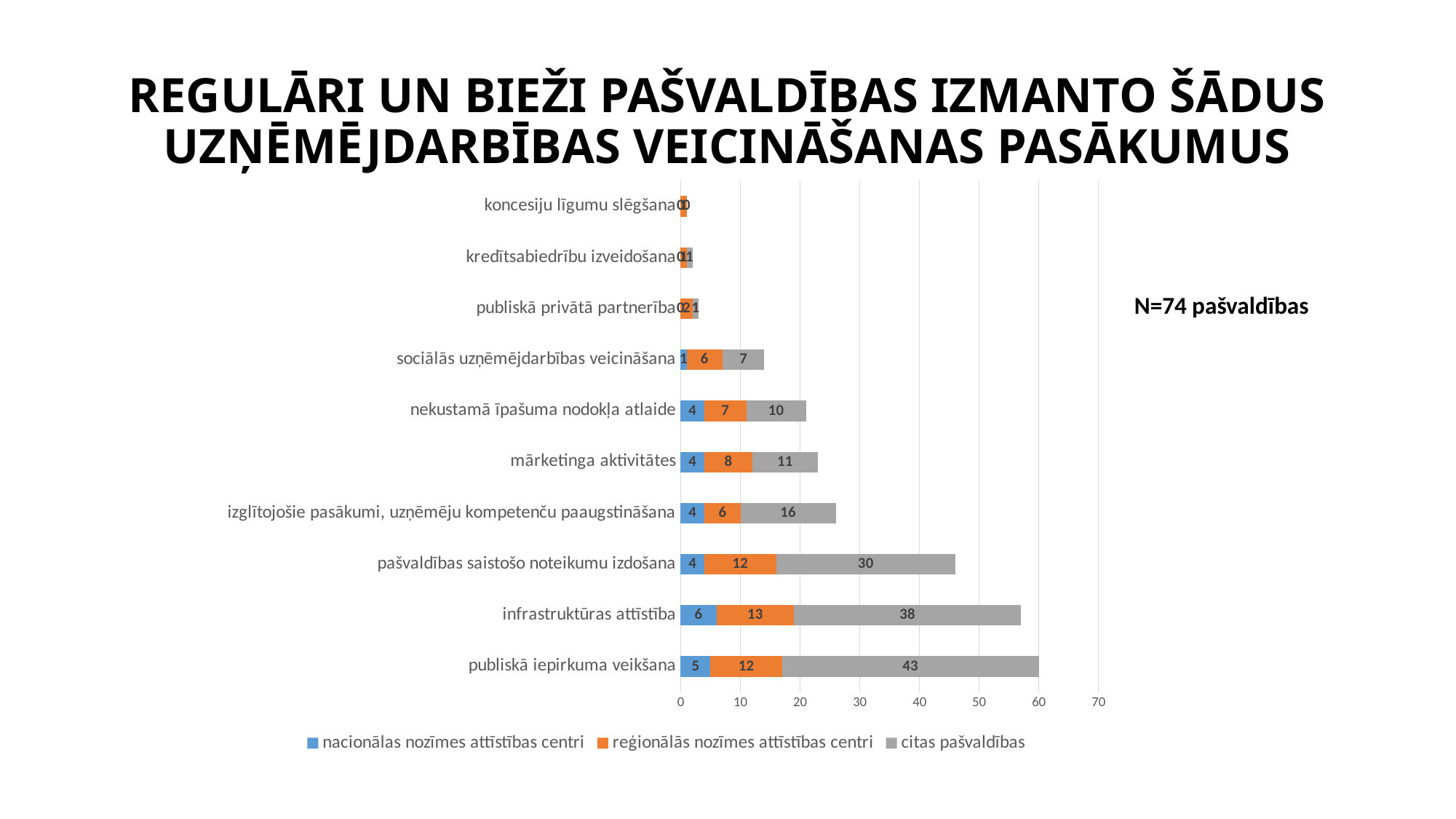
What is the difference between the 'citas pašvaldības' values for 'publiskā iepirkuma veikšana' and 'infrastruktūras attīstība'? 5 What type of chart is shown on the slide? stacked bar chart How many series does the legend list? 3 What sample size is stated next to the chart? N=74 pašvaldības What is the total of the stacked bar for 'infrastruktūras attīstība'? 57 What is the value for 'citas pašvaldības' in the 'publiskā iepirkuma veikšana' category? 43 How many categories are plotted on the chart? 10 Which is larger: the 'citas pašvaldības' value for 'mārketinga aktivitātes' or for 'izglītojošie pasākumi, uzņēmēju kompetenču paaugstināšana'? izglītojošie pasākumi, uzņēmēju kompetenču paaugstināšana What is the total of the stacked bar for 'pašvaldības saistošo noteikumu izdošana'? 46 Which category has the highest value for 'citas pašvaldības'? publiskā iepirkuma veikšana What is the value for 'reģionālās nozīmes attīstības centri' in the 'infrastruktūras attīstība' category? 13 What is the value for 'nacionālas nozīmes attīstības centri' in the 'sociālās uzņēmējdarbības veicināšana' category? 1